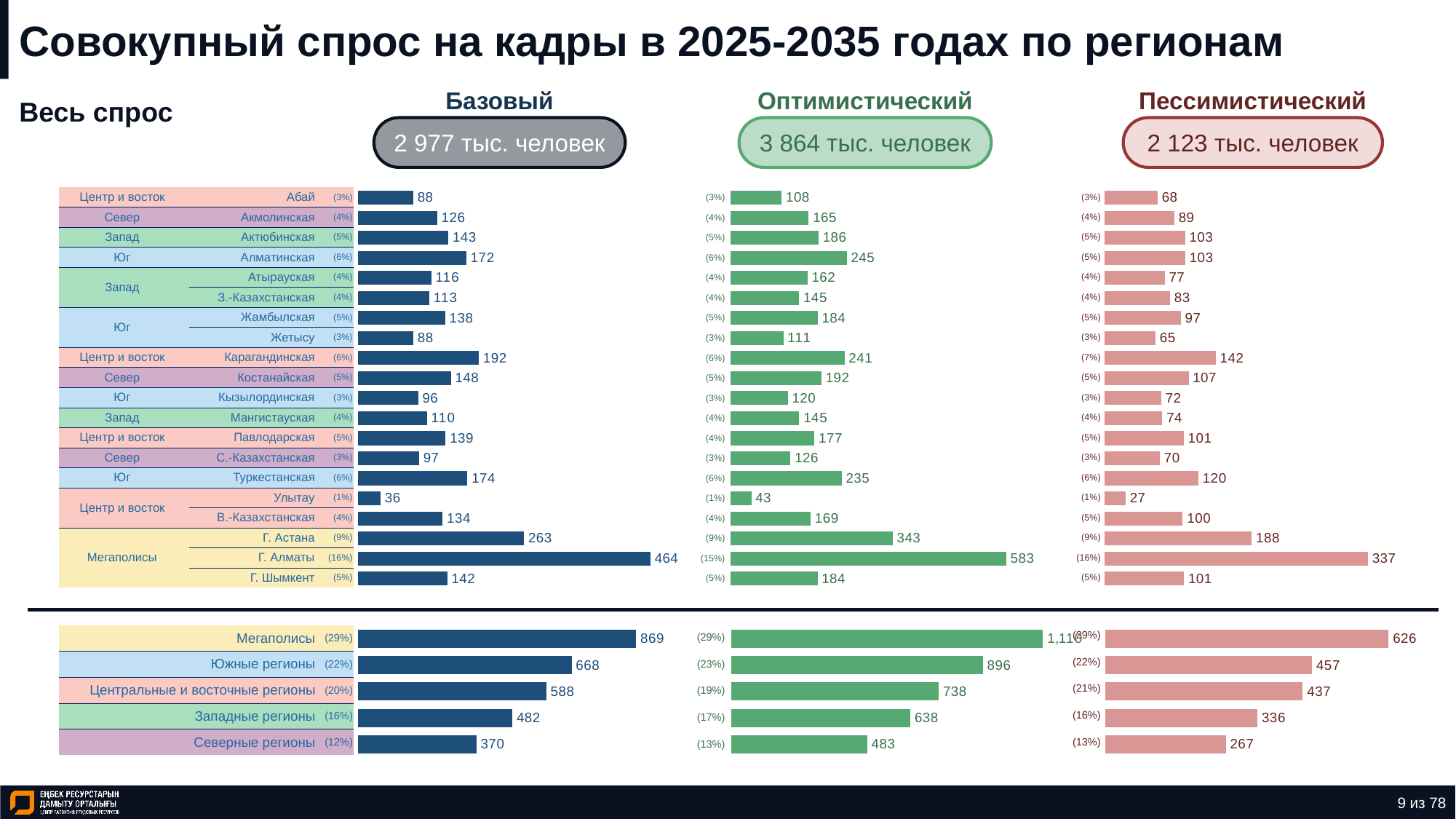
In the lower Базовый chart, what share is shown for Мегаполисы? 29% In the Базовый chart, which is larger: the value for Алматинская or for Костанайская? Алматинская In the Пессимистический chart, what is the value for Г. Астана? 188 In the Базовый chart (upper section), which region has the lowest value? Улытау In the Оптимистический chart, what is the value for Карагандинская? 241 In the Базовый chart, what is the difference between the values for Г. Астана and Г. Шымкент? 121 In the lower Пессимистический chart, what is the value for Мегаполисы? 626 In the Базовый chart, what is the value for Г. Алматы? 464 How many regions are listed in the upper section of the Базовый chart? 20 In the Базовый chart (upper section), which region has the highest value? Г. Алматы What total is shown for the Оптимистический scenario? 3 864 тыс. человек What kind of chart is used to show the regional values on this slide? Bar chart